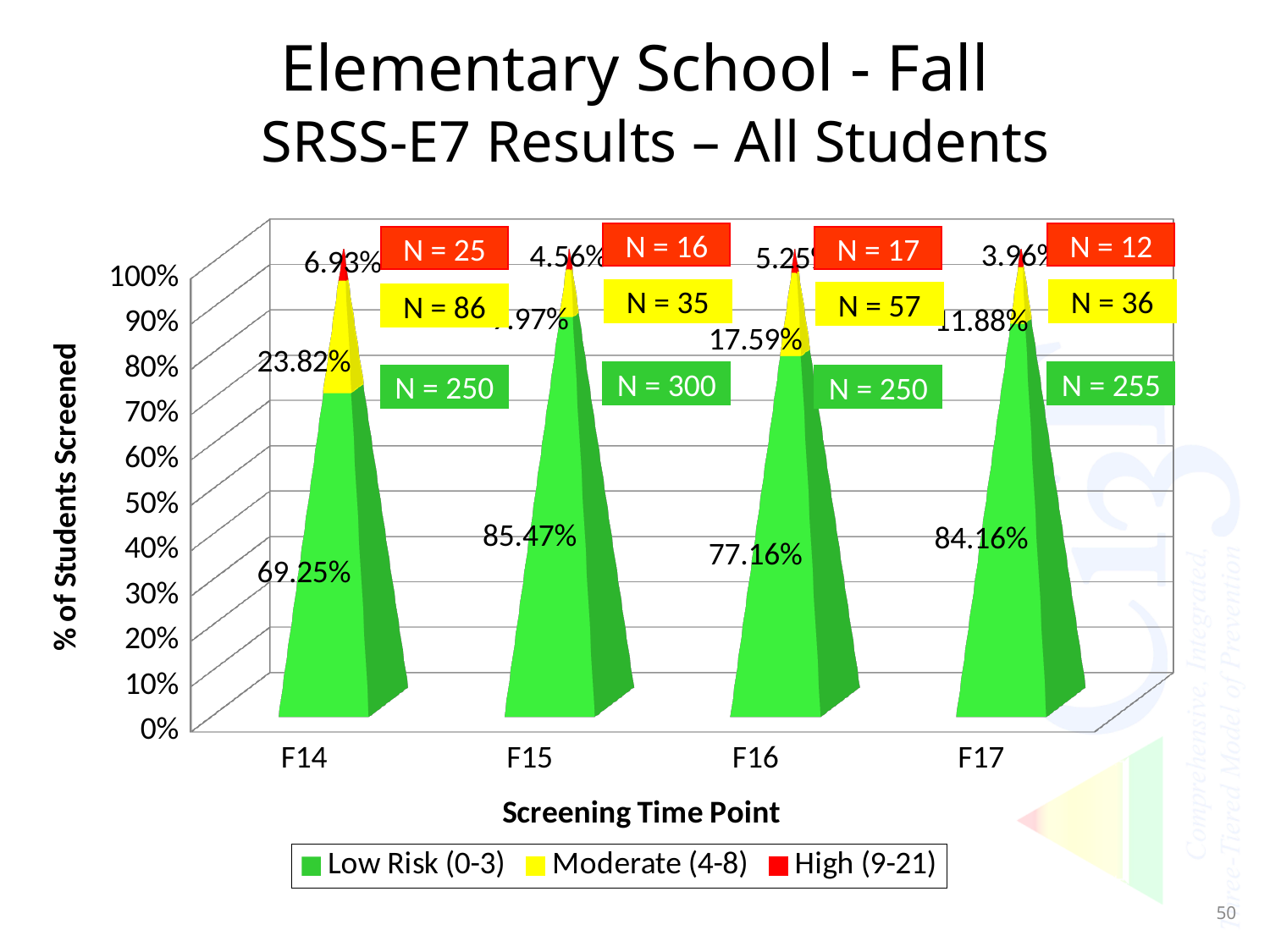
What is the difference between the Low Risk (0-3) percentages for F15 and F14? 16.22% What is the Moderate (4-8) percentage for F14? 23.82% What is the High (9-21) percentage for F17? 3.96% Which screening time point has the lowest Low Risk (0-3) percentage? F14 What is the Low Risk (0-3) percentage for F16? 77.16% What is the Low Risk (0-3) percentage for F14? 69.25% How many series does the legend list? 3 Which has a larger Low Risk (0-3) percentage, F16 or F17? F17 What is the Moderate (4-8) percentage for F17? 11.88% What is the title of the x axis? Screening Time Point How many screening time points are shown on the x axis? 4 Which screening time point has the highest Low Risk (0-3) percentage? F15